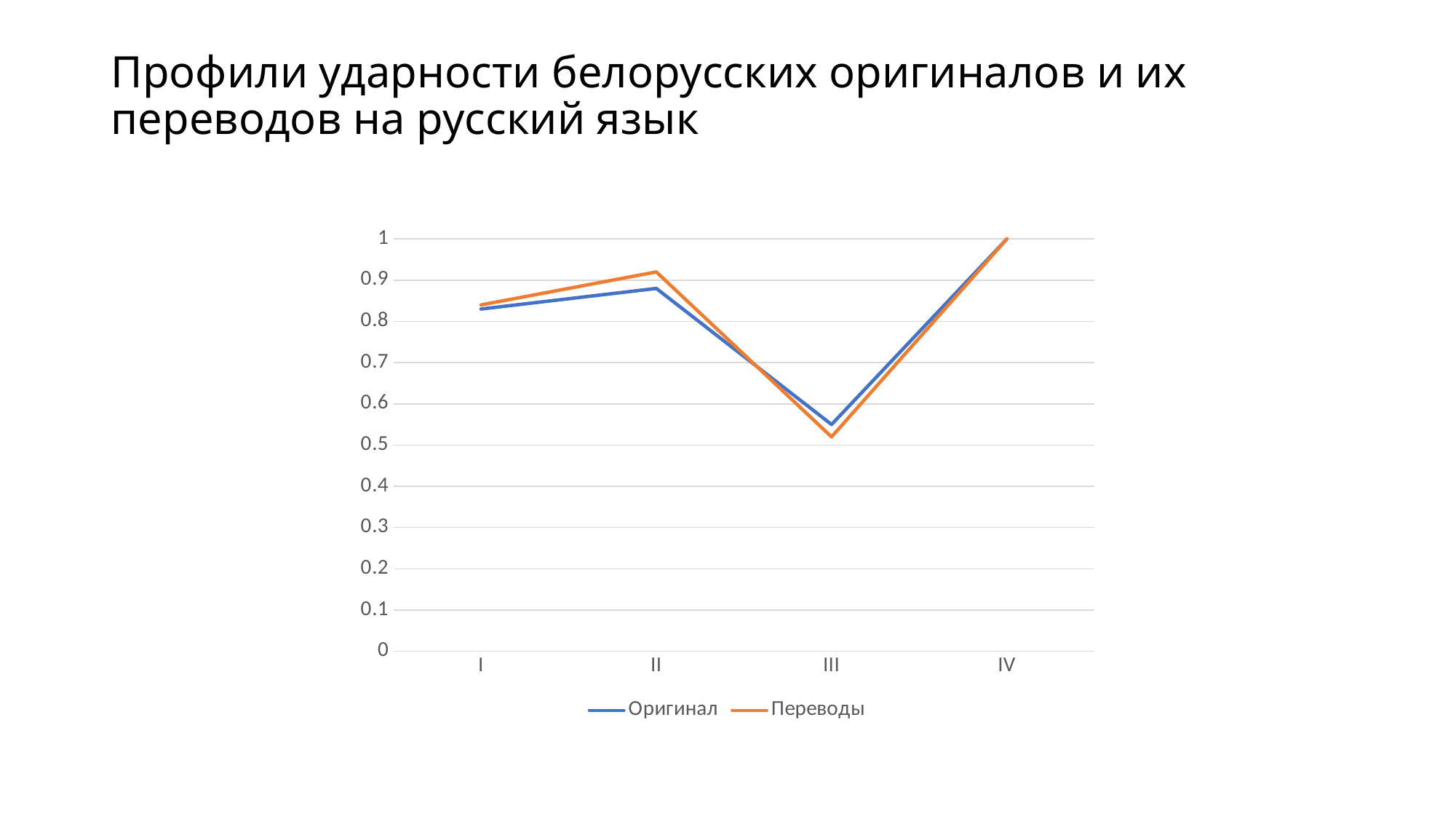
What is the value for Оригинал at IV? 1 Which series is drawn in orange? Переводы Do the values rise or fall from II to III? fall How many categories are shown on the x axis? 4 Is the value for Оригинал at II greater or less than 0.8? greater What is the value for Переводы at IV? 1 Is the value for Переводы at III greater or less than 0.6? less At II, which series has the higher value, Оригинал or Переводы? Переводы At which category is the Оригинал line lowest? III At which category is the Переводы line highest? IV How many series does the legend list? 2 What kind of chart is shown on the slide? line chart